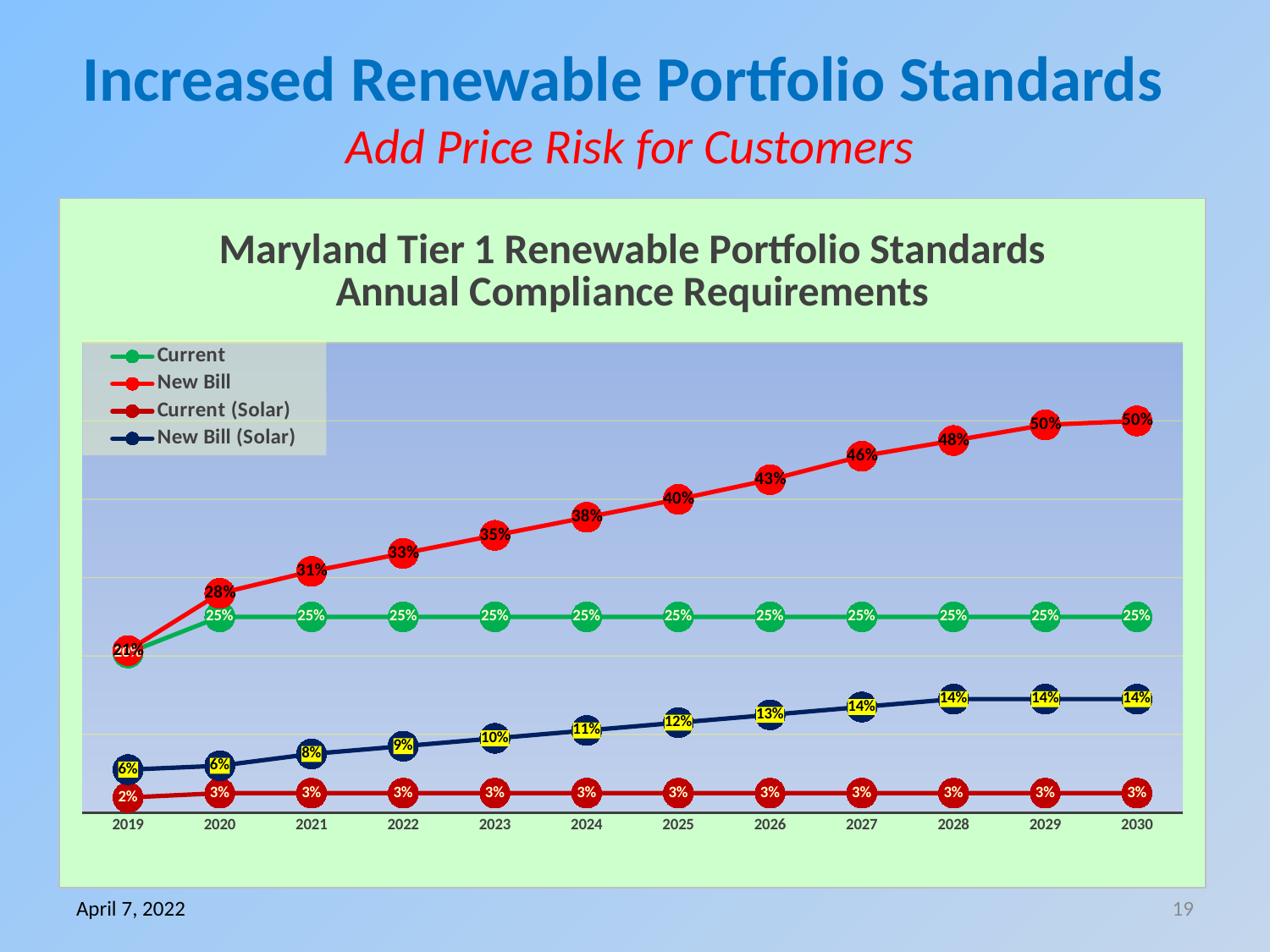
What is the Current value for 2025? 25% Does the New Bill (Solar) series rise or fall from 2019 to 2028? Rise What is the difference between the New Bill and Current values in 2030? 25% What is the New Bill (Solar) value for 2024? 11% In which year is the New Bill series at its lowest value? 2019 Which is larger in 2022: the New Bill value or the Current value? New Bill What is the New Bill value for 2030? 50% What is the Current (Solar) value for 2019? 2% How many years are shown on the x axis? 12 How many series does the legend list? 4 What kind of chart is shown on the slide? Line chart What is the title of the chart? Maryland Tier 1 Renewable Portfolio Standards Annual Compliance Requirements